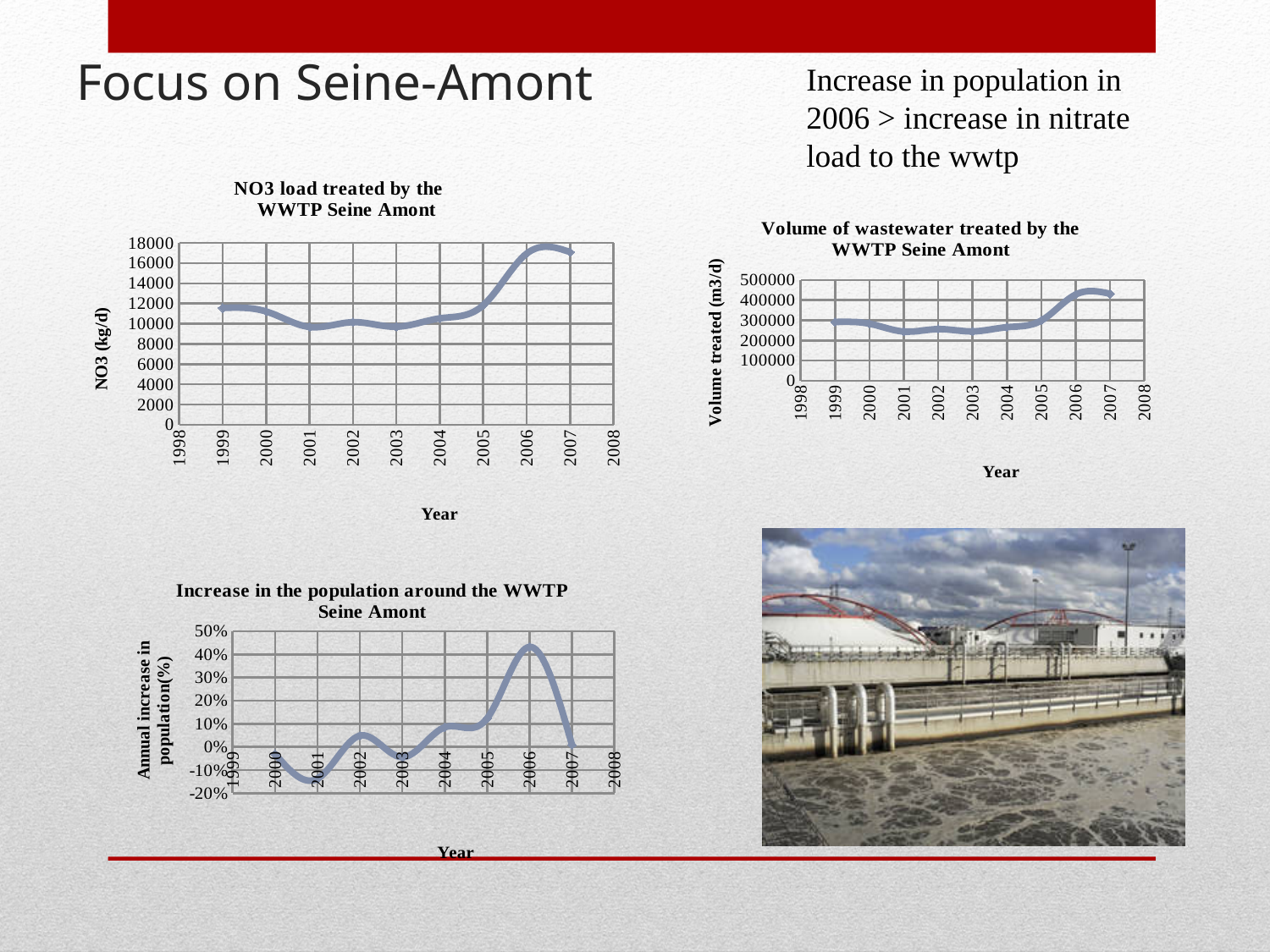
What is the y-axis title of the 'Volume of wastewater treated by the WWTP Seine Amont' chart? Volume treated (m3/d) In the 'Increase in the population around the WWTP Seine Amont' chart, which year has the lowest annual increase? 2001 In the 'Increase in the population around the WWTP Seine Amont' chart, is the value for 2006 greater or less than 30%? greater In the 'NO3 load treated by the WWTP Seine Amont' chart, which year has the highest NO3 load? 2007 In the 'Volume of wastewater treated by the WWTP Seine Amont' chart, is the value for 2006 greater or less than 400000? greater How many charts are shown on the slide? 3 In the 'Increase in the population around the WWTP Seine Amont' chart, which year has the highest annual increase? 2006 In the 'Volume of wastewater treated by the WWTP Seine Amont' chart, is the volume treated in 2006 larger or smaller than in 2001? larger In the 'Volume of wastewater treated by the WWTP Seine Amont' chart, is the value for 2003 greater or less than 300000? less What kind of chart is the 'NO3 load treated by the WWTP Seine Amont' chart? line chart